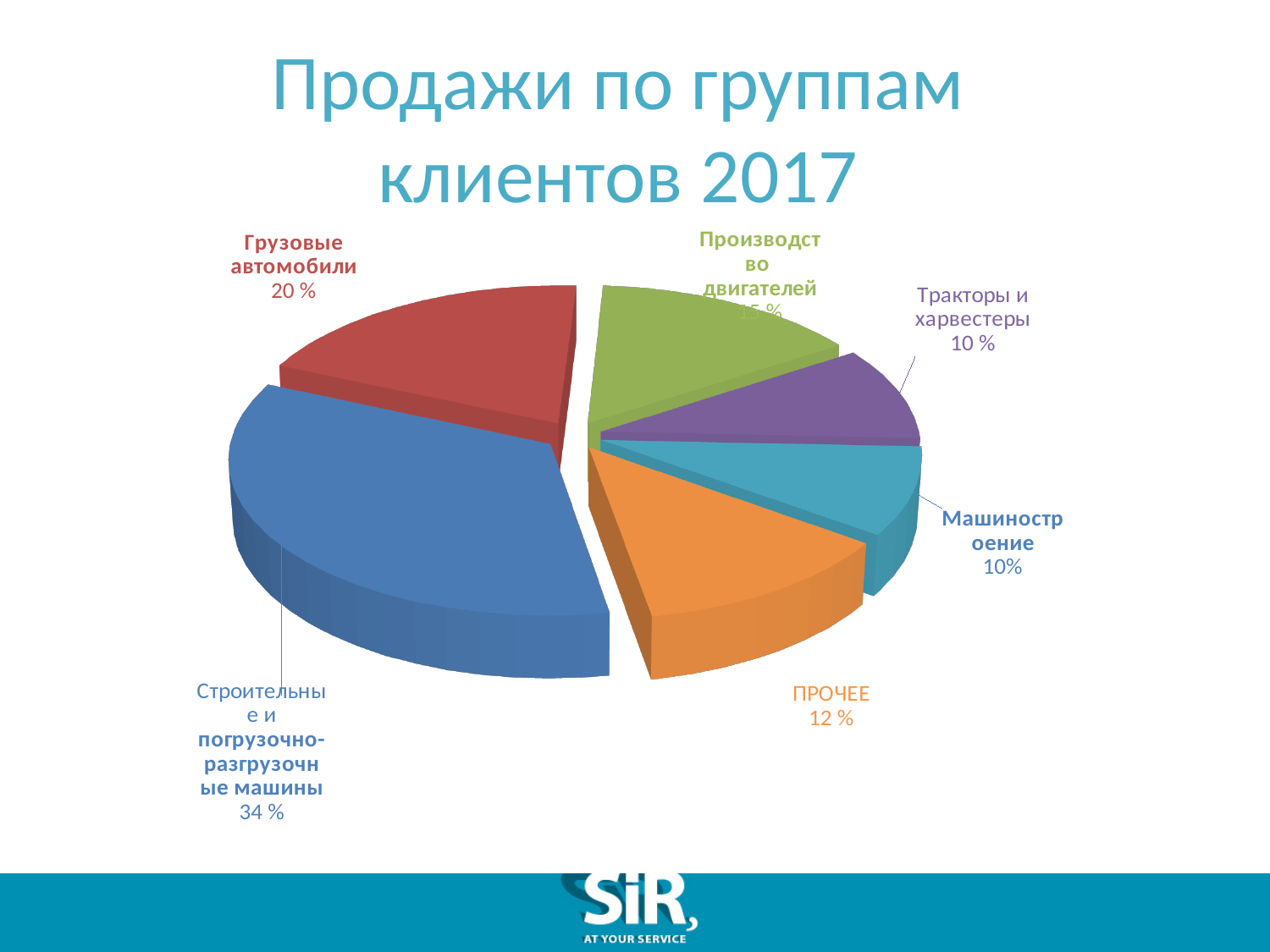
What share of sales is shown for Тракторы и харвестеры? 10 % Which has a larger share, Грузовые автомобили or ПРОЧЕЕ? Грузовые автомобили What is the difference between the shares of Строительные и погрузочно-разгрузочные машины and Грузовые автомобили? 14 % What share of sales is shown for Машиностроение? 10% What share of sales is shown for ПРОЧЕЕ? 12 % Which customer group has the largest share of sales? Строительные и погрузочно-разгрузочные машины What is the title of the chart on the slide? Продажи по группам клиентов 2017 How many customer groups (slices) does the pie chart show? 6 What colour is the slice for Строительные и погрузочно-разгрузочные машины? Blue What kind of chart is shown on the slide? Pie chart What share of sales is shown for Строительные и погрузочно-разгрузочные машины? 34 % What share of sales is shown for Грузовые автомобили? 20 %